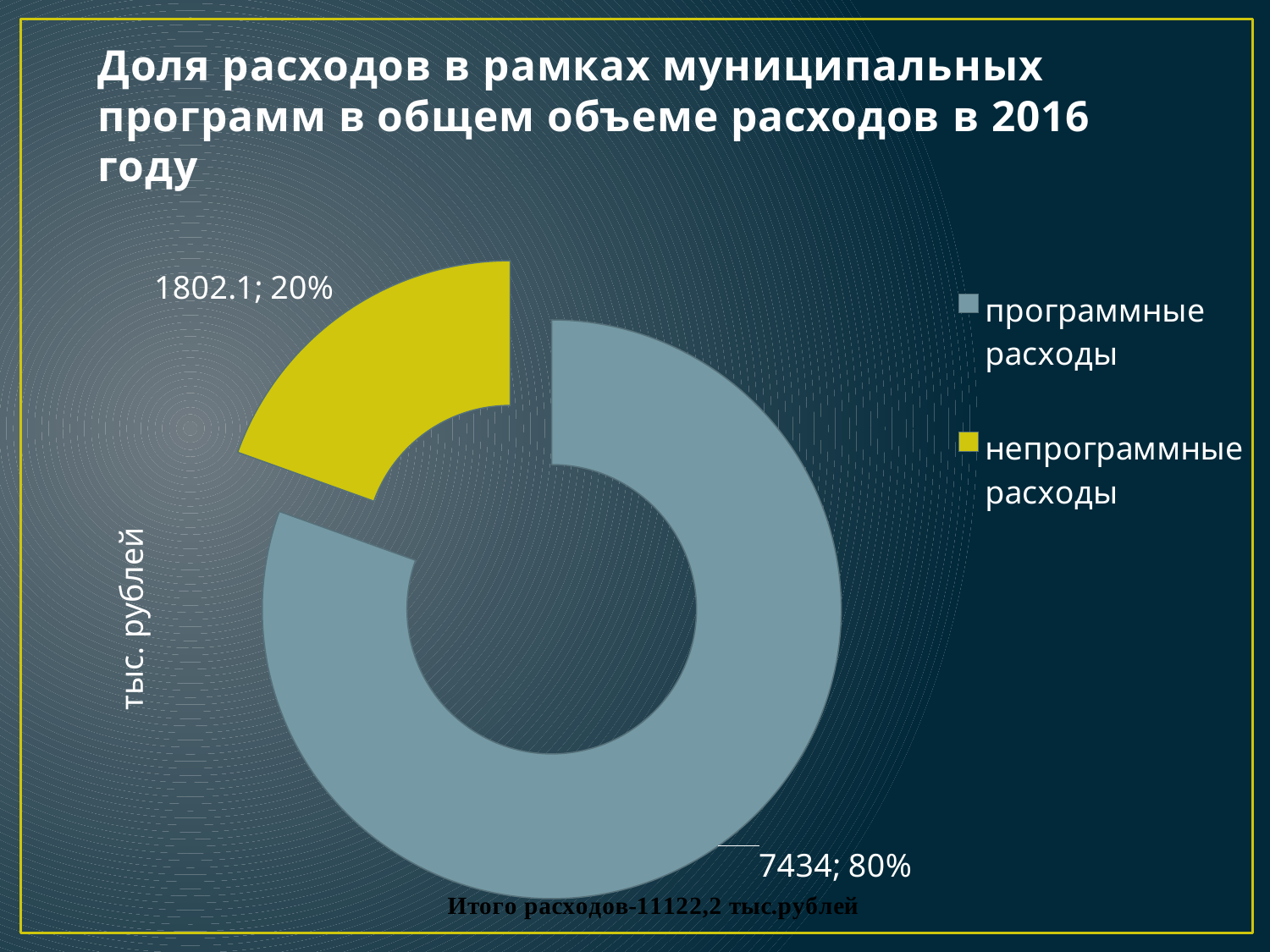
Which is larger, программные расходы or непрограммные расходы? программные расходы What share of the chart do программные расходы make up? 80% What is the value shown for непрограммные расходы? 1802.1 Which category has the largest slice? программные расходы Which category has the smallest slice? непрограммные расходы What share of the chart do непрограммные расходы make up? 20% What is the value shown for программные расходы? 7434 How many categories does the chart show? 2 What is the difference between the values for программные расходы and непрограммные расходы? 5631.9 What unit is given on the label beside the chart? тыс. рублей What kind of chart is shown on the slide? doughnut chart What colour is the slice for непрограммные расходы? yellow